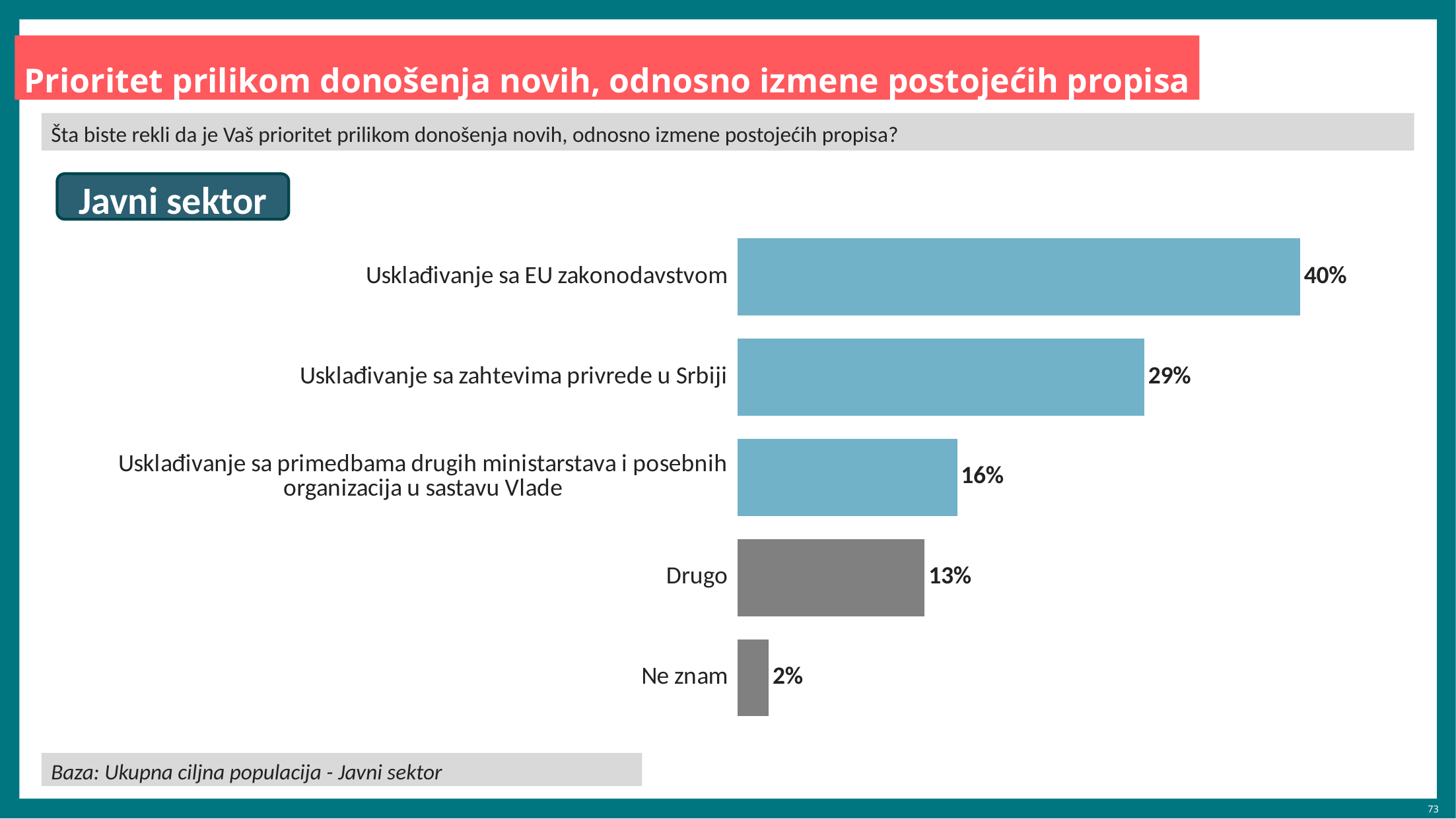
What kind of chart is shown on the slide? Bar chart What is the value for "Drugo"? 13% Which category has the highest value? Usklađivanje sa EU zakonodavstvom What is the value for "Usklađivanje sa zahtevima privrede u Srbiji"? 29% How many categories are shown in the chart? 5 What is the value for "Usklađivanje sa primedbama drugih ministarstava i posebnih organizacija u sastavu Vlade"? 16% What is the value for "Usklađivanje sa EU zakonodavstvom"? 40% Which sector does the chart on the slide refer to? Javni sektor What is the difference between the values for "Usklađivanje sa EU zakonodavstvom" and "Usklađivanje sa zahtevima privrede u Srbiji"? 11% Which category has the lowest value? Ne znam What is the value for "Ne znam"? 2% Which is larger: the value for "Drugo" or the value for "Usklađivanje sa primedbama drugih ministarstava i posebnih organizacija u sastavu Vlade"? Usklađivanje sa primedbama drugih ministarstava i posebnih organizacija u sastavu Vlade